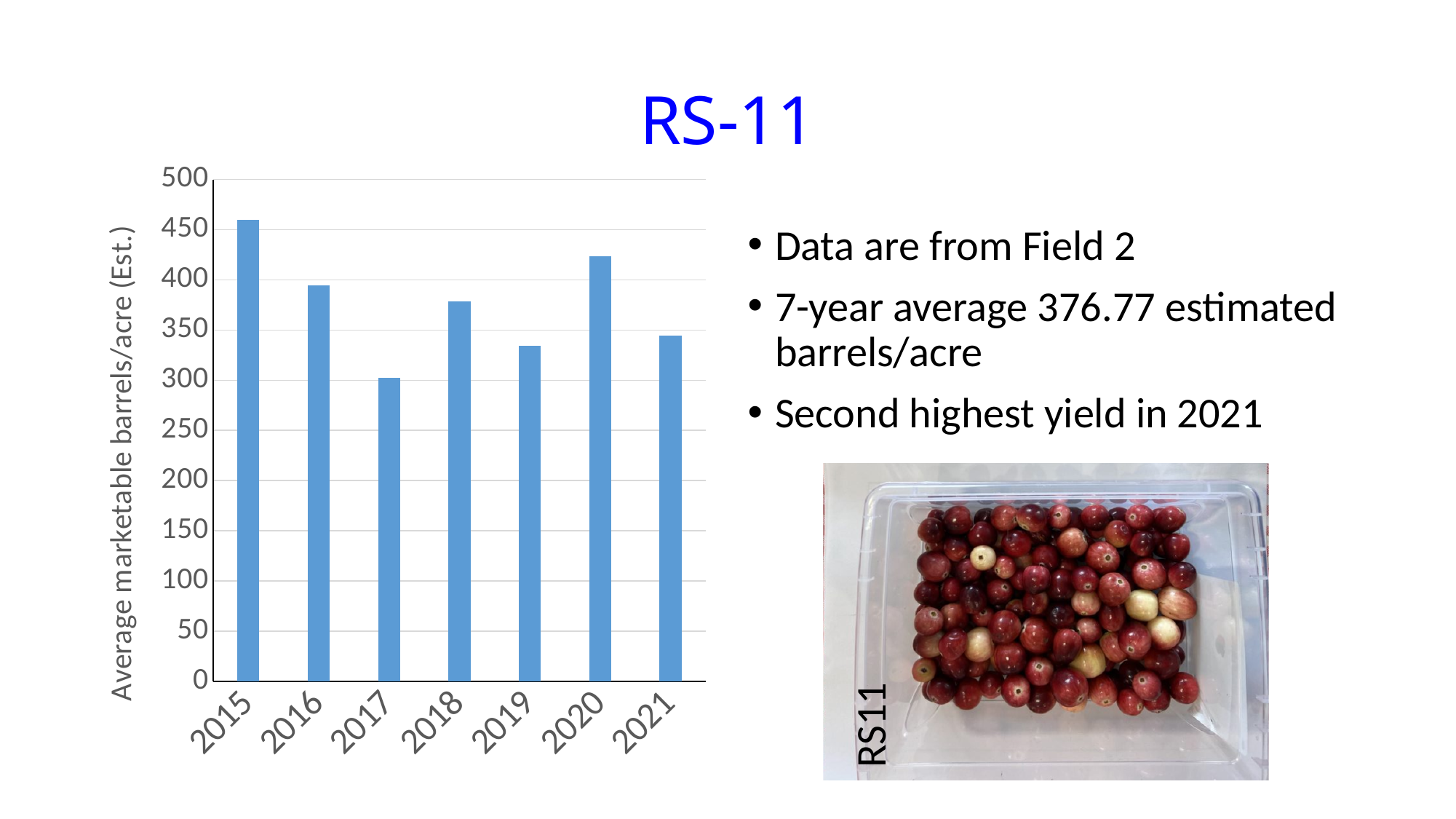
Is the value for 2015 greater or less than 400? greater Which year has the highest average marketable barrels/acre? 2015 Is the value for 2020 greater or less than 400? greater Do the values rise or fall from 2015 to 2017? fall What kind of chart is shown on the slide? bar chart Is the value for 2019 greater or less than 350? less Which year has the larger value, 2020 or 2021? 2020 Which year has the lowest average marketable barrels/acre? 2017 How many years are plotted on the x axis of the chart? 7 What is the label of the vertical axis of the chart? Average marketable barrels/acre (Est.)